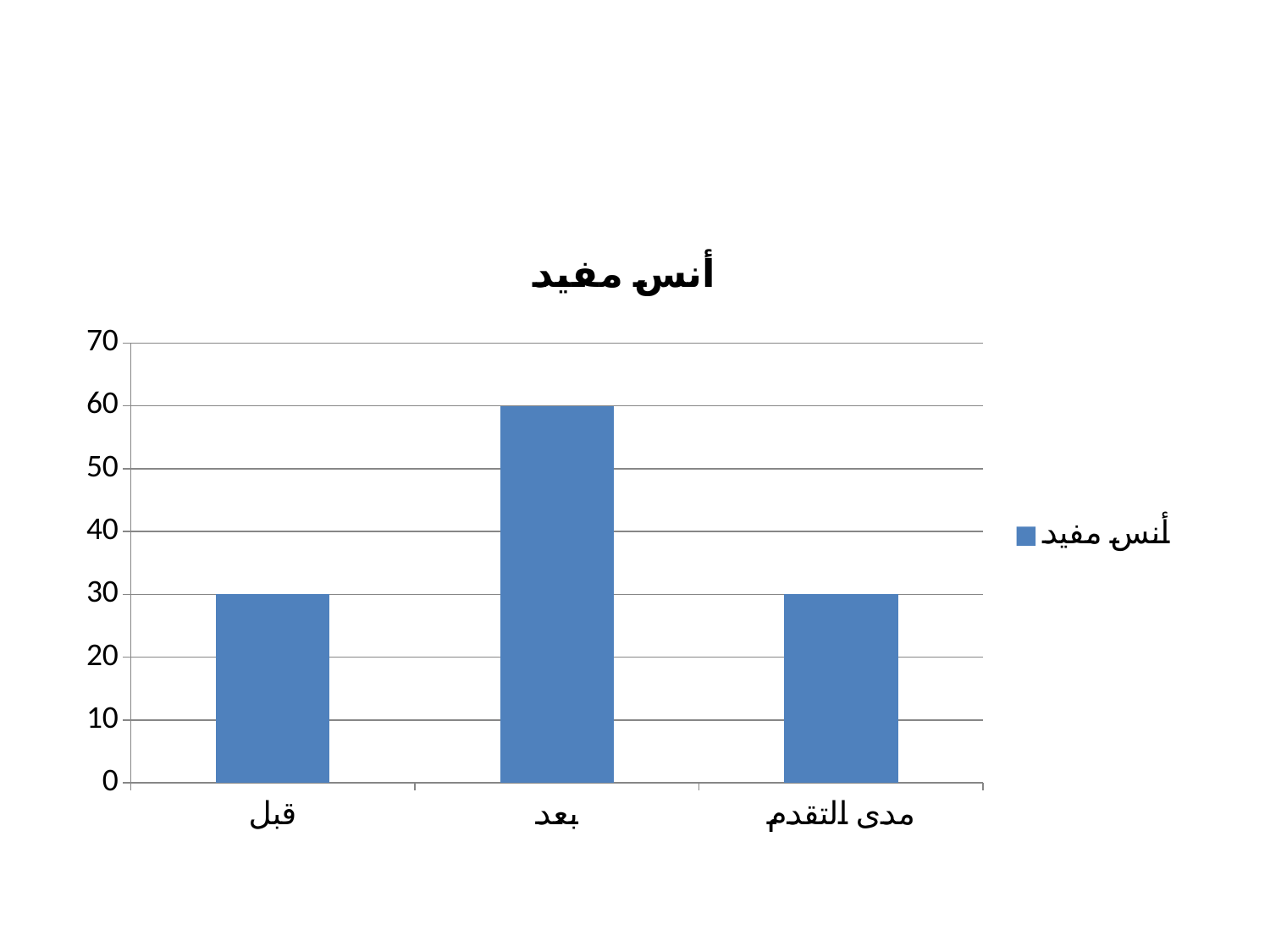
Which is larger, the value for بعد or the value for مدى التقدم? بعد How many categories are shown on the x axis? 3 What is the value for قبل? 30 What kind of chart is shown? bar chart What is the title of the chart? أنس مفيد How many series does the legend list? 1 What is the value for بعد? 60 What is the difference between the values for بعد and قبل? 30 Which category has the highest value? بعد Is the value for قبل greater or less than 40? less What is the value for مدى التقدم? 30 Is the value for بعد greater or less than 50? greater